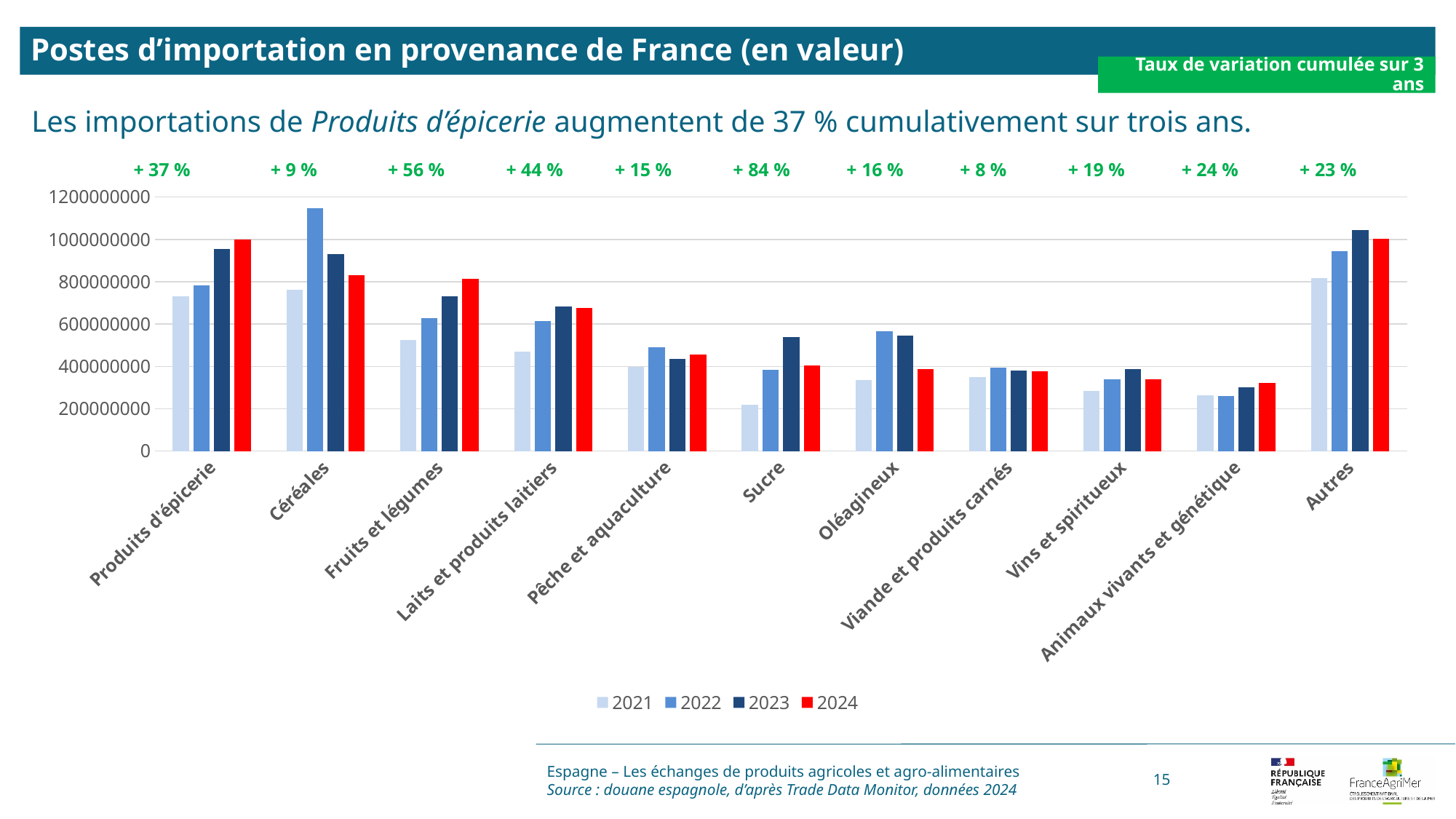
How many product categories are shown on the x axis of the chart? 11 How many series does the chart legend list? 4 What is the cumulative 3-year variation rate printed above the Sucre category? + 84 % What kind of chart is shown on the slide? bar chart What is the title of the chart on the slide? Postes d'importation en provenance de France (en valeur) What is the cumulative 3-year variation rate printed above the Fruits et légumes category? + 56 % Is the 2021 value for Sucre greater or less than 400000000? less Which category has the highest cumulative 3-year variation rate printed above it? Sucre Which category has the lowest cumulative 3-year variation rate printed above it? Viande et produits carnés Is the 2022 value for Céréales greater or less than 1000000000? greater Do the values for Produits d'épicerie rise or fall from 2021 to 2024? rise For Oléagineux, which is larger: the 2022 value or the 2024 value? 2022